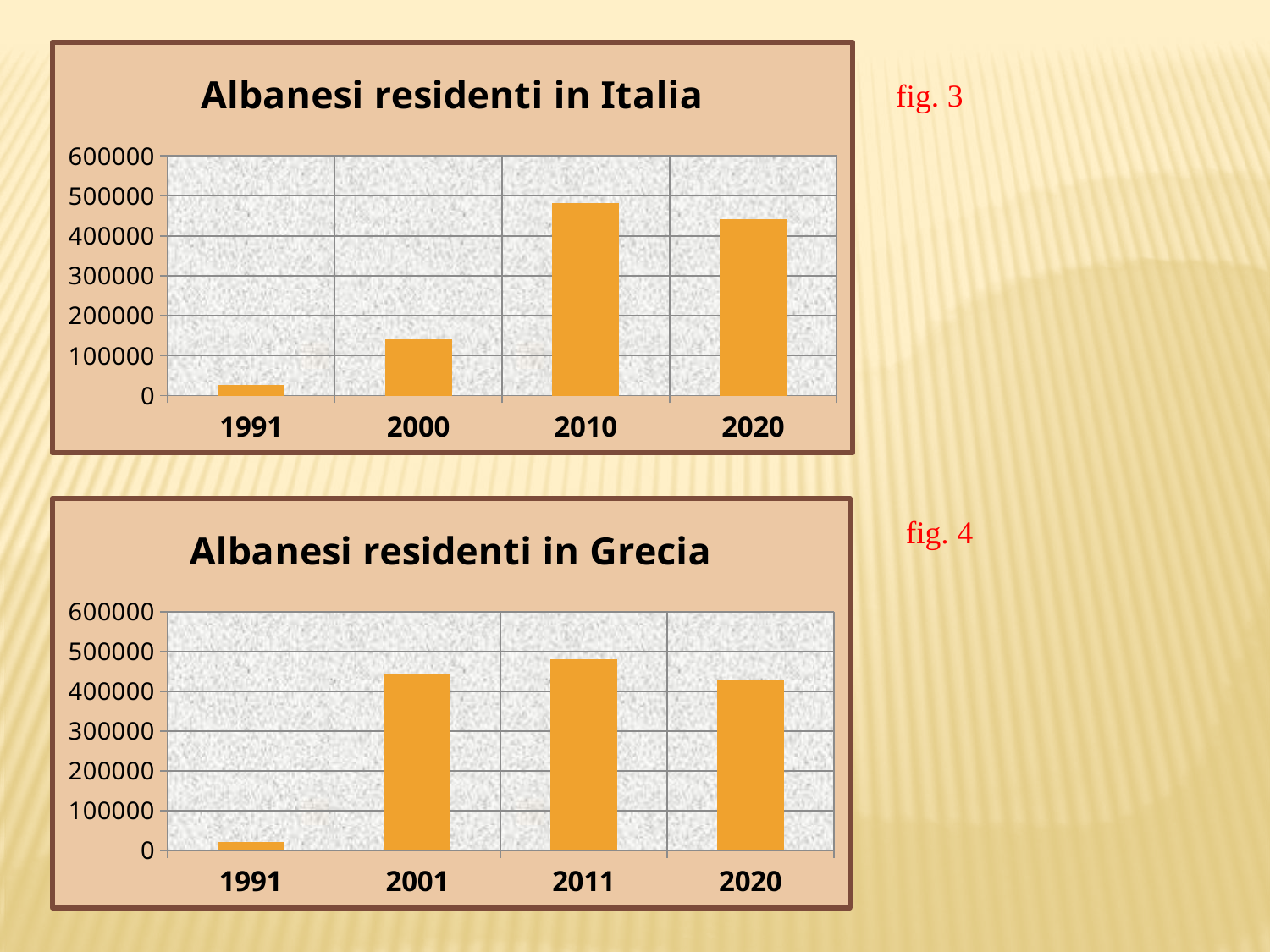
In the "Albanesi residenti in Italia" chart, which year has the highest value? 2010 What kind of chart is "Albanesi residenti in Grecia"? bar chart What is the title of the lower chart on the slide? Albanesi residenti in Grecia In the "Albanesi residenti in Italia" chart, is the value for 2020 greater or less than 400000? greater In the "Albanesi residenti in Italia" chart, which year has the lowest value? 1991 In the "Albanesi residenti in Grecia" chart, is the value for 1991 greater or less than 100000? less In the "Albanesi residenti in Grecia" chart, which year has the lowest value? 1991 What kind of chart is "Albanesi residenti in Italia"? bar chart How many years are shown on the x axis of the "Albanesi residenti in Italia" chart? 4 In the "Albanesi residenti in Grecia" chart, which year has the highest value? 2011 In the "Albanesi residenti in Italia" chart, which is larger, the value for 2010 or the value for 2020? 2010 In the "Albanesi residenti in Italia" chart, is the value for 2000 greater or less than 200000? less